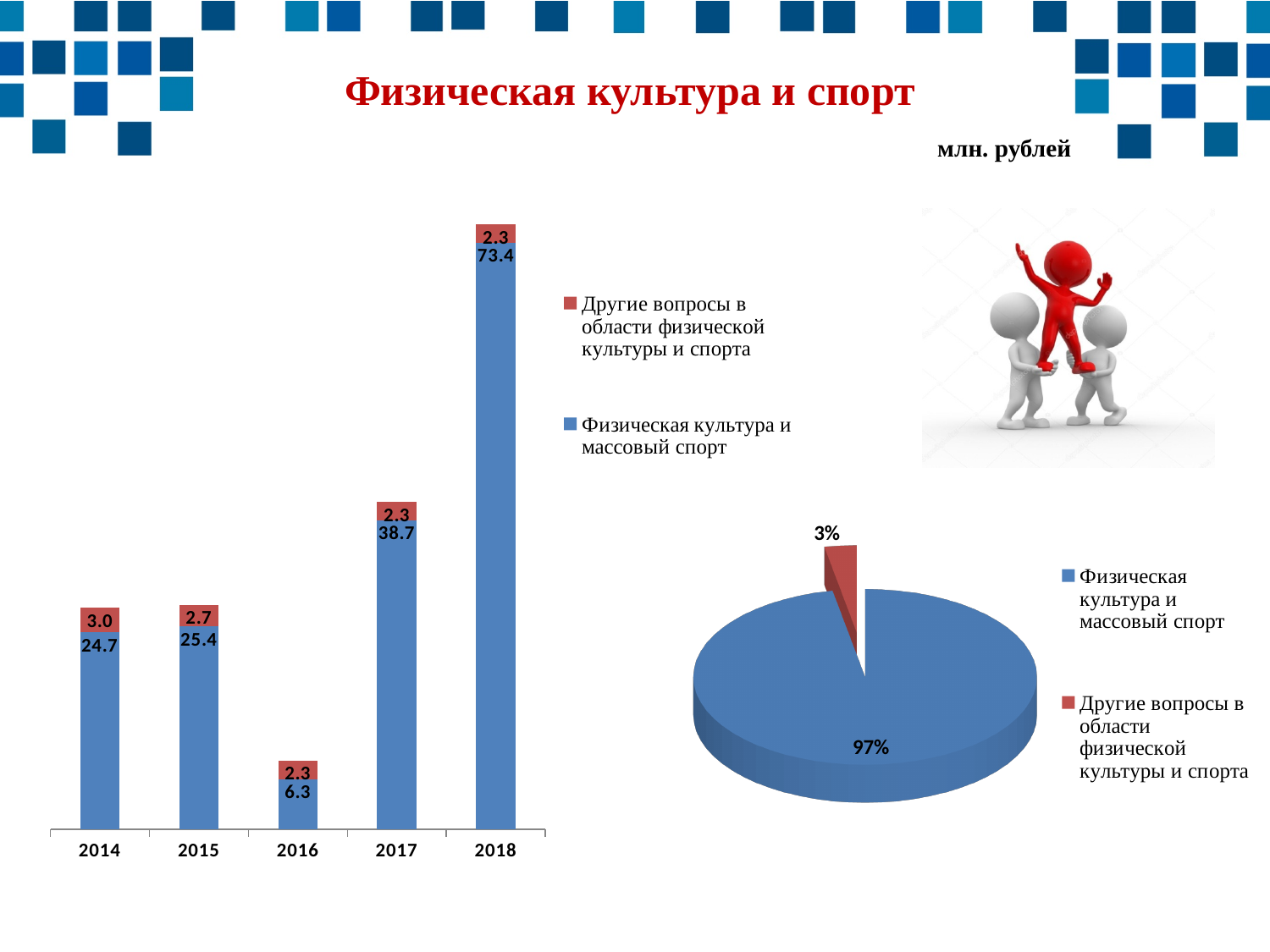
In the bar chart on the left, how many series does the legend list? 2 In the bar chart on the left, what is the value for "Физическая культура и массовый спорт" in 2016? 6.3 In the bar chart on the left, which is larger: the "Физическая культура и массовый спорт" value for 2015 or for 2014? 2015 In the bar chart on the left, what is the value for "Физическая культура и массовый спорт" in 2018? 73.4 In the pie chart on the right, what share does "Другие вопросы в области физической культуры и спорта" have? 3% In the bar chart on the left, what is the difference between the "Физическая культура и массовый спорт" values for 2018 and 2017? 34.7 In the bar chart on the left, what is the value for "Другие вопросы в области физической культуры и спорта" in 2014? 3.0 What kind of chart is the chart on the right of the slide? Pie chart In the bar chart on the left, how many years are shown on the x axis? 5 In the bar chart on the left, which year has the highest value for "Физическая культура и массовый спорт"? 2018 In the bar chart on the left, what is the total of the stacked bar for 2018? 75.7 In the bar chart on the left, which year has the lowest value for "Физическая культура и массовый спорт"? 2016